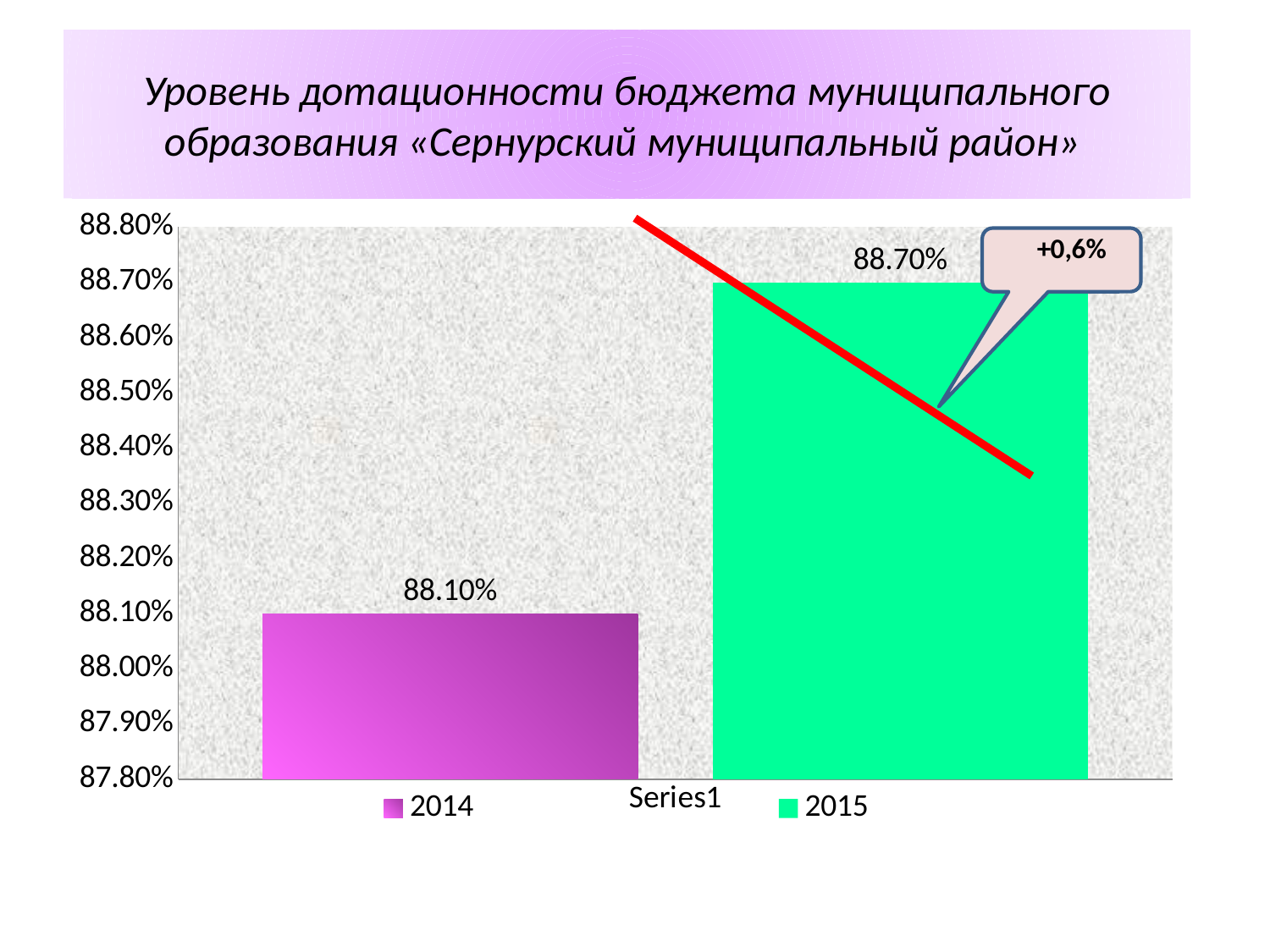
What change is shown in the callout on the chart? +0,6% Which series has the higher value, 2014 or 2015? 2015 What is the difference between the 2015 value and the 2014 value? 0.60% Is the value for 2014 greater or less than 88.40%? less What is the value for 2015? 88.70% What kind of chart is shown on the slide? bar chart Is the value for 2015 greater or less than 88.50%? greater How many series does the legend list? 2 Which series has the lower value, 2014 or 2015? 2014 What is the value for 2014? 88.10% What colour is the bar for 2015? green Does the value rise or fall from 2014 to 2015? rise